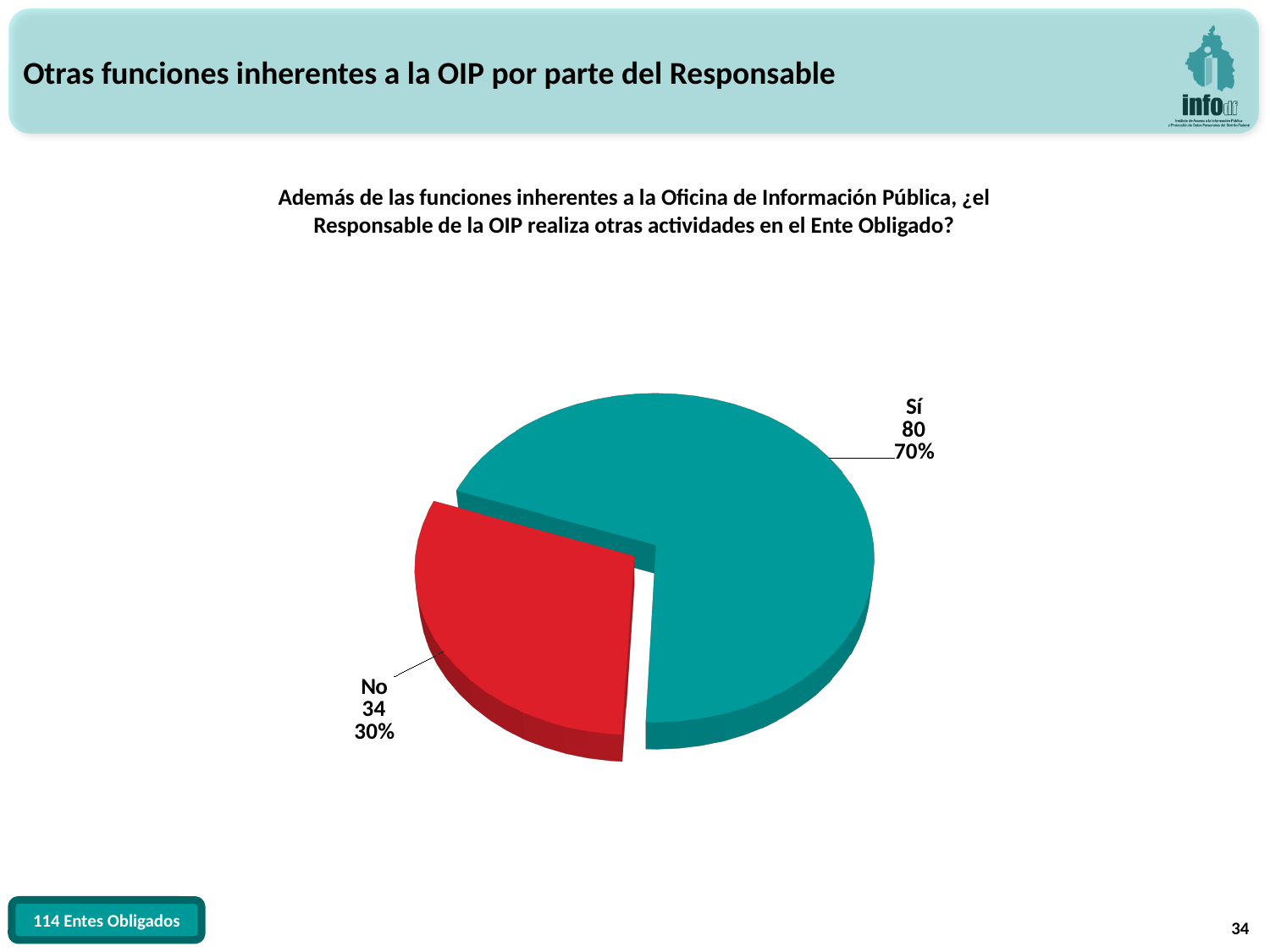
What percentage share does the 'No' slice represent? 30% What percentage share does the 'Sí' slice represent? 70% What is the difference between the 'Sí' count and the 'No' count? 46 What is the count for the 'Sí' slice? 80 What is the count for the 'No' slice? 34 Which slice is the largest? Sí What is the total of the two slice counts? 114 What colour is the 'No' slice? red How many slices does the pie chart have? 2 Which slice is the smallest? No What kind of chart is shown on the slide? pie chart Which is larger, the 'Sí' slice or the 'No' slice? Sí